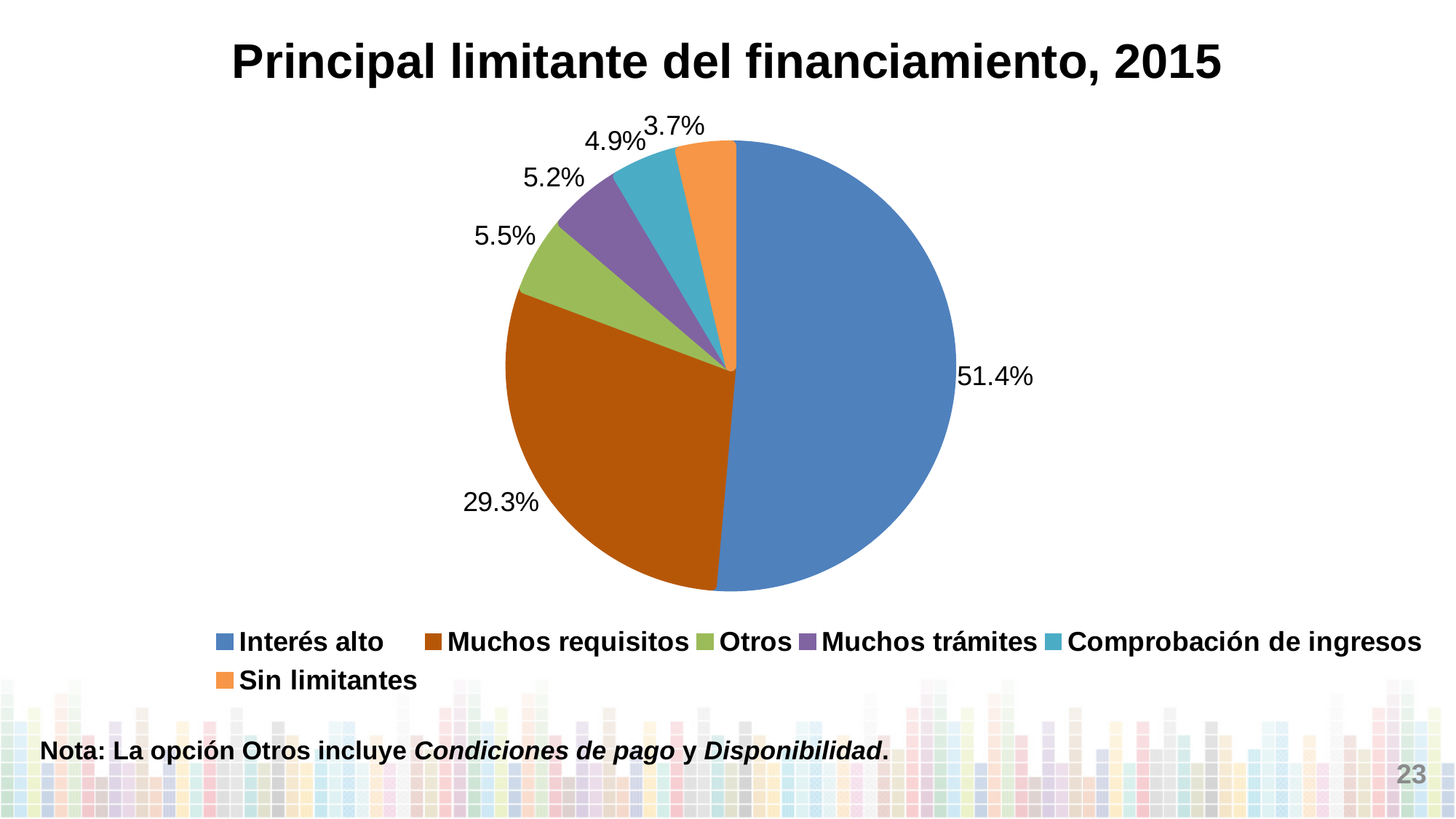
Which category has the largest slice of the pie? Interés alto How many categories does the legend list? 6 What is the value shown for Muchos requisitos? 29.3% What is the title of the chart? Principal limitante del financiamiento, 2015 What is the value shown for Sin limitantes? 3.7% Which category has the smallest slice of the pie? Sin limitantes What is the value shown for Otros? 5.5% What type of chart is shown on the slide? pie chart What is the difference between the values for Interés alto and Muchos requisitos? 22.1% What is the value shown for Comprobación de ingresos? 4.9% What share of the pie does Interés alto represent? 51.4% Which is larger, the value for Muchos trámites or the value for Sin limitantes? Muchos trámites